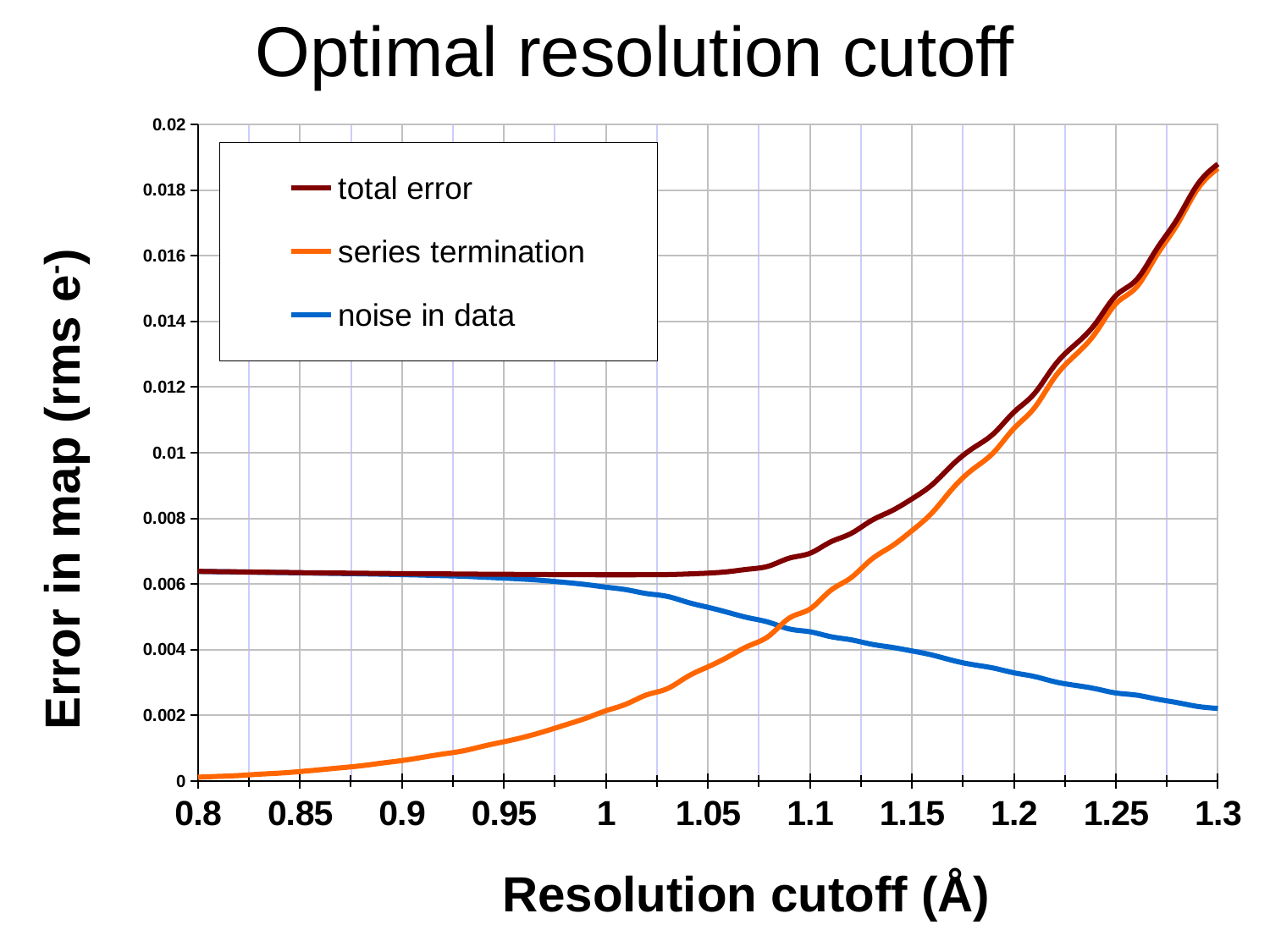
What is the title of the chart? Optimal resolution cutoff Does the 'noise in data' line rise or fall as the resolution cutoff increases from 0.8 to 1.3? fall At a resolution cutoff of 1.3, which is higher: 'series termination' or 'noise in data'? series termination How many series does the legend list? 3 Which series has the lowest value at a resolution cutoff of 1.3? noise in data At a resolution cutoff of 0.8, which is higher: 'noise in data' or 'series termination'? noise in data Is the value of 'noise in data' at a resolution cutoff of 1.3 greater or less than 0.004? less Is the value of 'series termination' at a resolution cutoff of 1.3 greater or less than 0.016? greater Is the value of 'series termination' at a resolution cutoff of 0.8 greater or less than 0.002? less Does the 'series termination' line rise or fall as the resolution cutoff increases from 0.8 to 1.3? rise What kind of chart is shown on the slide? line chart